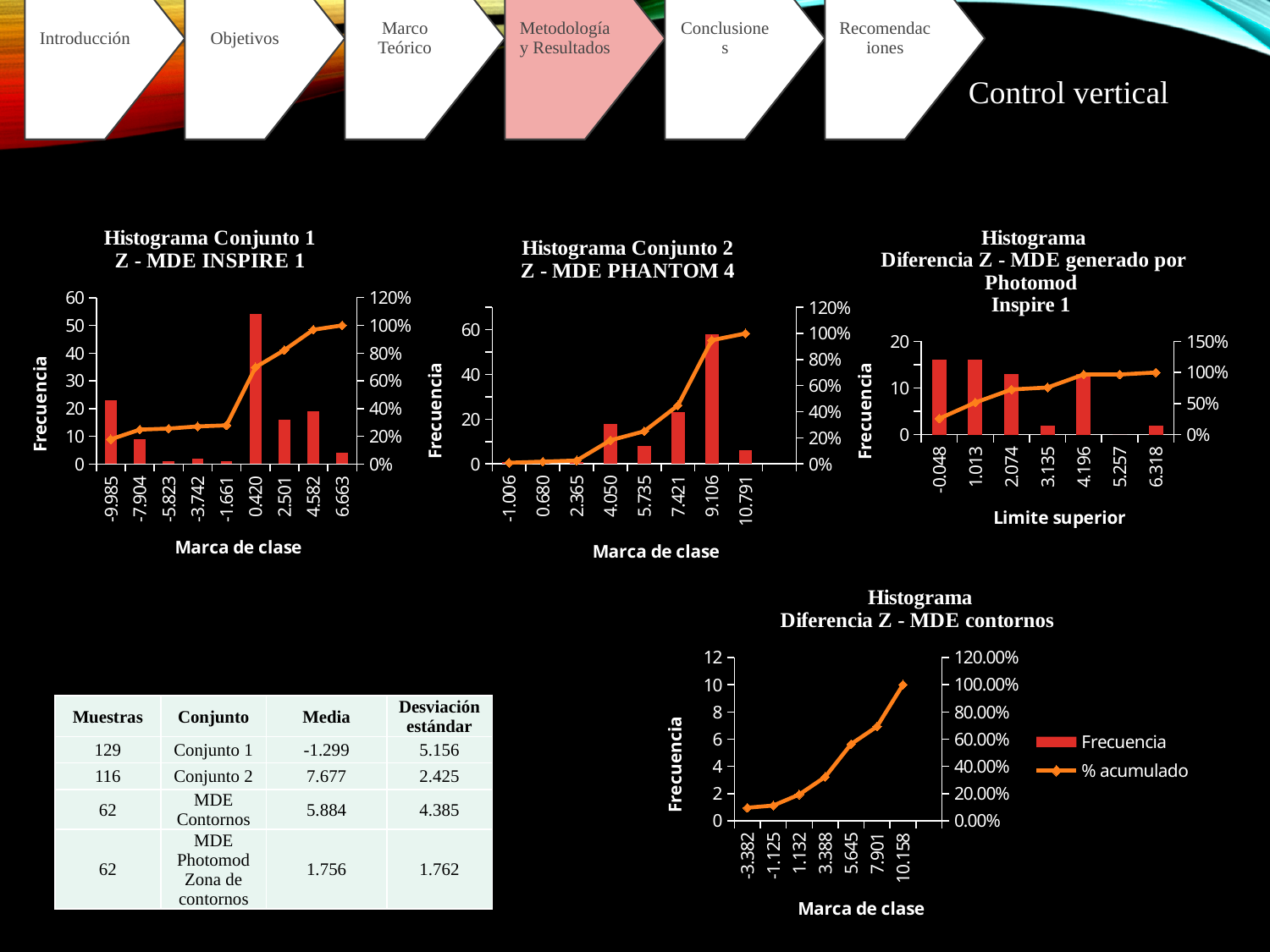
In the chart titled 'Histograma Conjunto 2 Z - MDE PHANTOM 4', how many Marca de clase categories are shown on the x axis? 8 In the chart titled 'Histograma Conjunto 2 Z - MDE PHANTOM 4', which Marca de clase has the highest Frecuencia bar? 9.106 In the chart titled 'Histograma Diferencia Z - MDE generado por Photomod Inspire 1', how many Limite superior categories are shown on the x axis? 7 In the chart titled 'Histograma Diferencia Z - MDE contornos', how many series does the legend list? 2 In the chart titled 'Histograma Conjunto 2 Z - MDE PHANTOM 4', is the Frecuencia for 4.050 greater or less than 20? less In the chart titled 'Histograma Conjunto 1 Z - MDE INSPIRE 1', is the Frecuencia for 0.420 greater or less than 50? greater In the chart titled 'Histograma Diferencia Z - MDE contornos', does the % acumulado line rise or fall from left to right along the x axis? rise In the chart titled 'Histograma Diferencia Z - MDE generado por Photomod Inspire 1', is the Frecuencia for 2.074 greater or less than 10? greater In the chart titled 'Histograma Conjunto 1 Z - MDE INSPIRE 1', what kind of chart is used to show Frecuencia? bar chart In the chart titled 'Histograma Conjunto 1 Z - MDE INSPIRE 1', how many Marca de clase categories are shown on the x axis? 9 In the chart titled 'Histograma Conjunto 1 Z - MDE INSPIRE 1', which has the larger Frecuencia bar, -9.985 or -7.904? -9.985 In the chart titled 'Histograma Conjunto 1 Z - MDE INSPIRE 1', which Marca de clase has the highest Frecuencia bar? 0.420